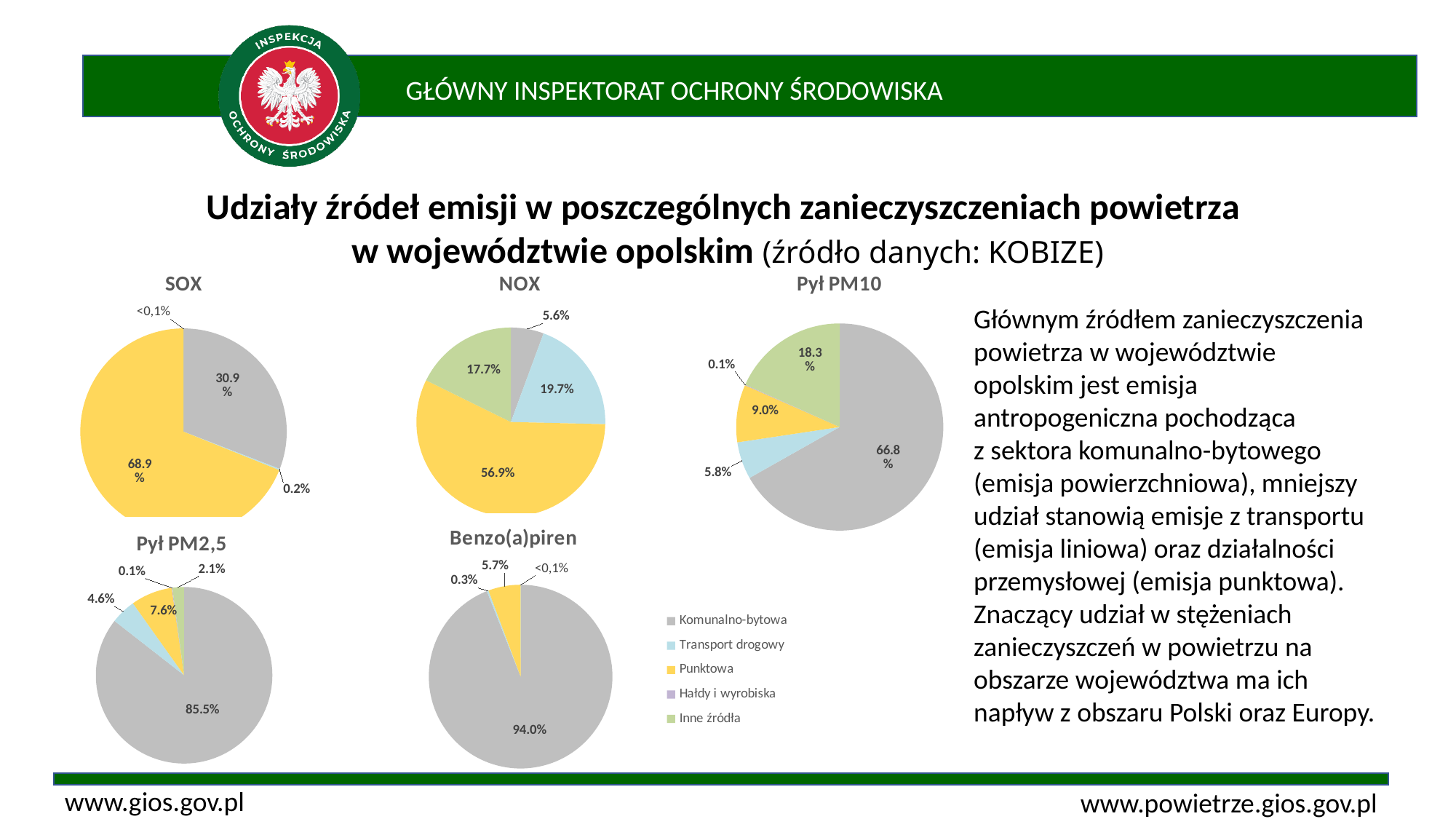
In the Pył PM10 chart, what share does Komunalno-bytowa have? 66.8% In the Pył PM10 chart, which is larger, Punktowa or Transport drogowy? Punktowa In the Pył PM2,5 chart, what share does Punktowa have? 7.6% In the SOX chart, what share does Komunalno-bytowa have? 30.9% In the Pył PM2,5 chart, what is the difference between the Komunalno-bytowa share and the Transport drogowy share? 80.9% In the NOX chart, what is the difference between the Punktowa share and the Inne źródła share? 39.2% In the SOX chart, what share does Punktowa have? 68.9% How many entries does the shared legend list? 5 In the Benzo(a)piren chart, what share does Komunalno-bytowa have? 94.0% In the NOX chart, what share does Transport drogowy have? 19.7% In the NOX chart, which source has the largest share? Punktowa What type of chart is used for SOX? Pie chart